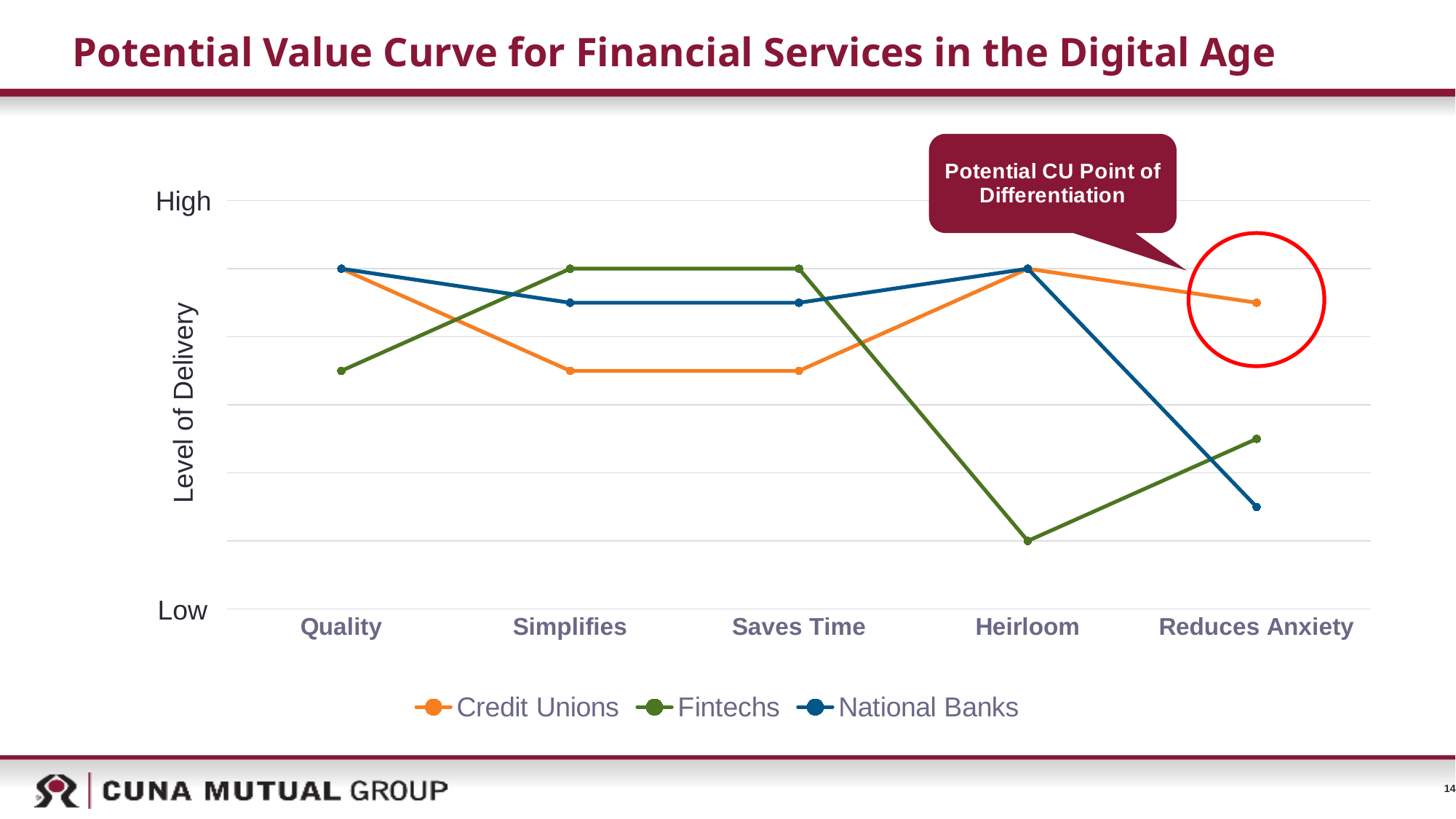
Does the Fintechs line rise or fall from Saves Time to Heirloom? fall Which category is circled and labelled as the Potential CU Point of Differentiation? Reduces Anxiety Does the National Banks line rise or fall from Heirloom to Reduces Anxiety? fall For which category is the National Banks line at its lowest? Reduces Anxiety How many series does the legend list? 3 Which series has the highest value for Reduces Anxiety? Credit Unions Which series has the lowest value for Heirloom? Fintechs For Reduces Anxiety, which is higher: Credit Unions or National Banks? Credit Unions What kind of chart is shown on the slide? line chart For Quality, which is higher: Fintechs or National Banks? National Banks How many categories are shown along the x axis? 5 For which category is the Fintechs line at its lowest? Heirloom